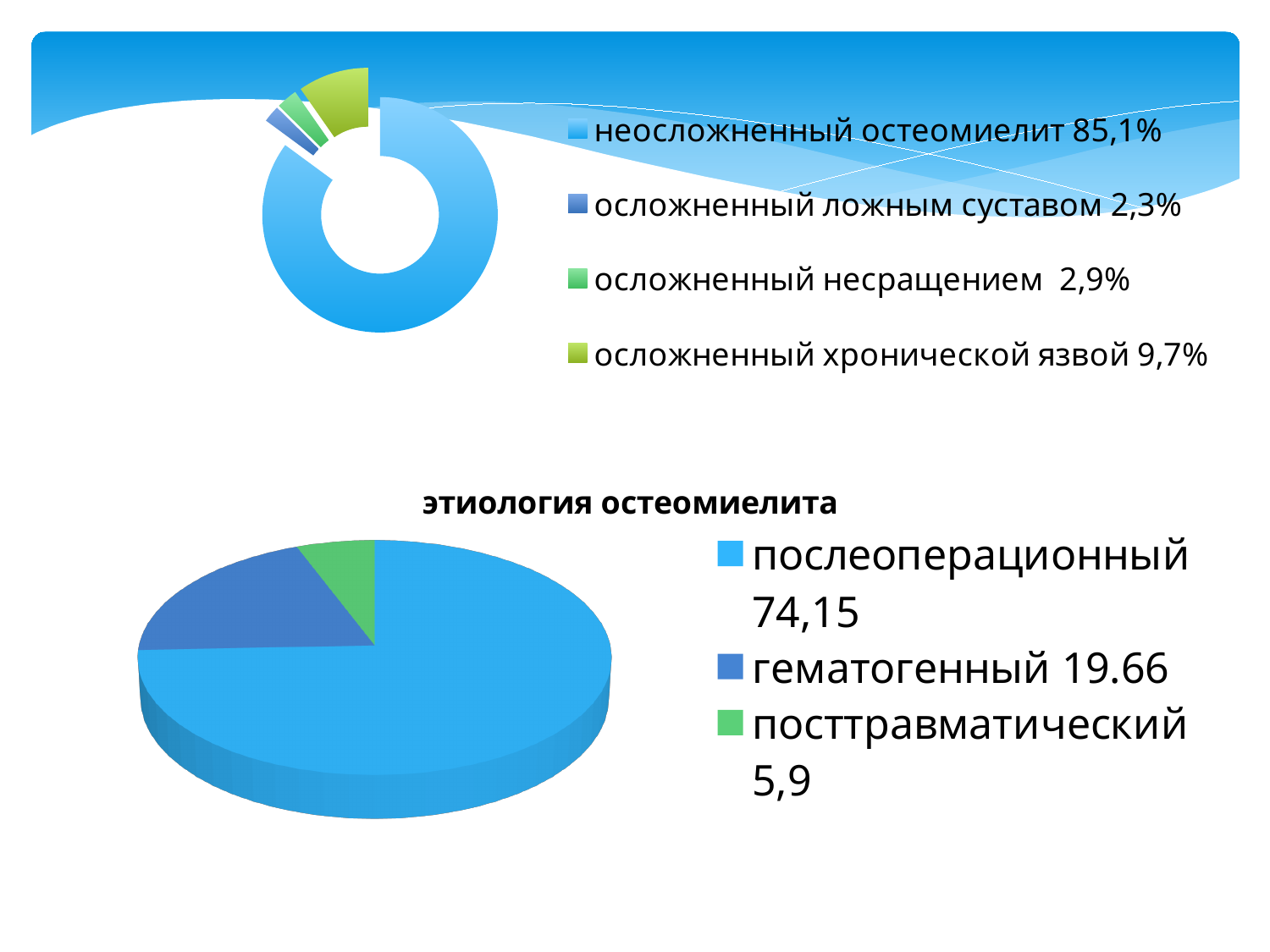
On the chart titled 'этиология остеомиелита', what value is shown for послеоперационный? 74,15 On the chart titled 'этиология остеомиелита', what value is shown for гематогенный? 19.66 On the chart titled 'этиология остеомиелита', which is larger: гематогенный or посттравматический? гематогенный On the top doughnut chart, what share is shown for осложненный хронической язвой? 9,7% On the top doughnut chart, what is the difference between the shares for осложненный хронической язвой and осложненный несращением? 6,8% On the top doughnut chart, which category has the smallest share? осложненный ложным суставом On the chart titled 'этиология остеомиелита', how many categories does the legend list? 3 On the chart titled 'этиология остеомиелита', which category has the smallest slice? посттравматический On the top doughnut chart, what share is shown for неосложненный остеомиелит? 85,1% On the top doughnut chart, how many categories does the legend list? 4 What kind of chart is the one titled 'этиология остеомиелита'? pie chart On the top doughnut chart, what share is shown for осложненный ложным суставом? 2,3%